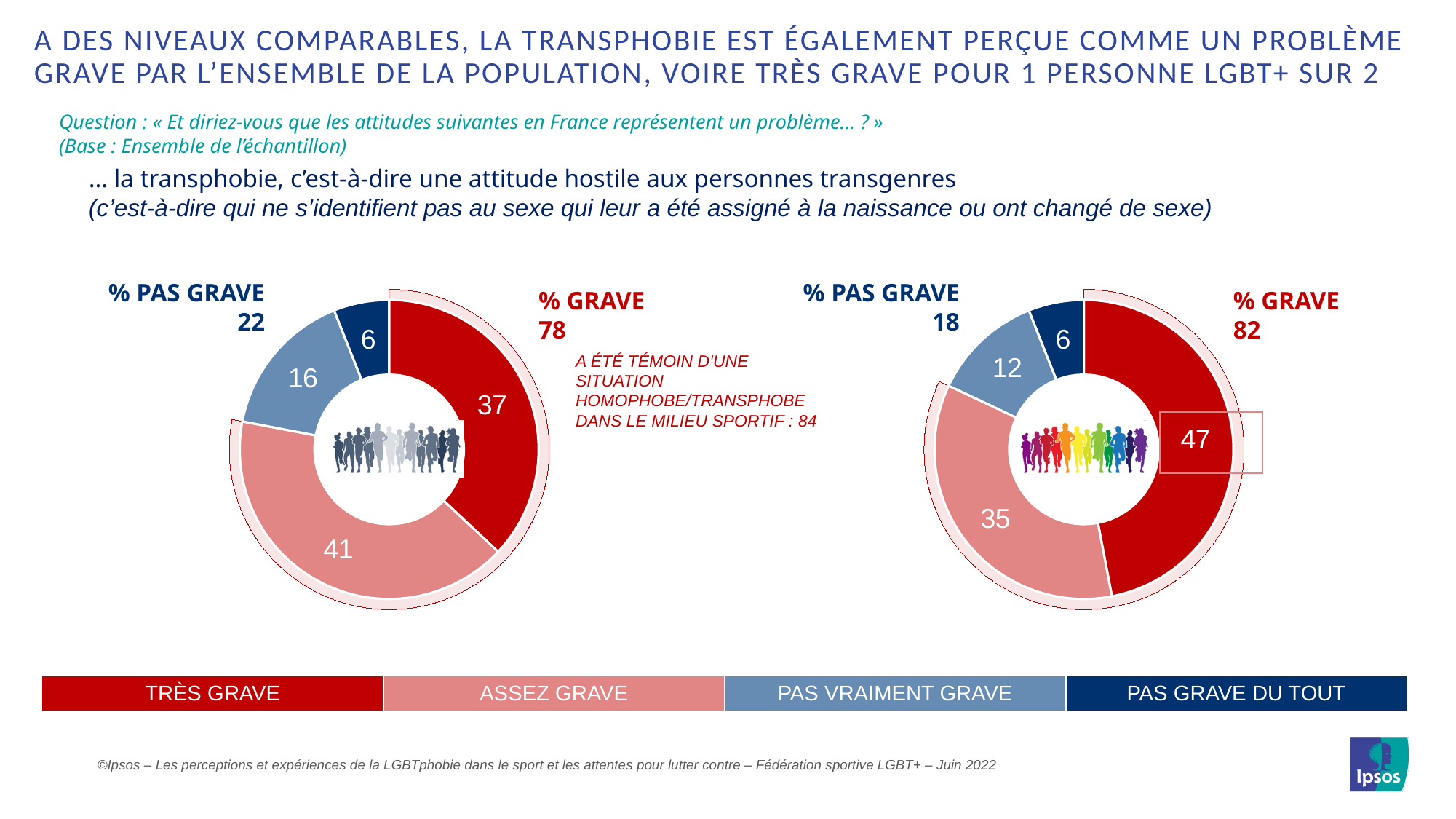
In the left donut chart, what is the value for TRÈS GRAVE? 37 In the right donut chart, what is the value for TRÈS GRAVE? 47 What is the % PAS GRAVE total shown next to the right donut chart? 18 In the right donut chart, which category has the smallest share? PAS GRAVE DU TOUT What type of chart is used on the left of the slide? Donut (pie) chart Which is larger in the right donut chart: TRÈS GRAVE or ASSEZ GRAVE? TRÈS GRAVE In the left donut chart, what is the value for ASSEZ GRAVE? 41 What is the difference between the TRÈS GRAVE values in the right and left donut charts? 10 In the right donut chart, what is the value for PAS VRAIMENT GRAVE? 12 What is the % GRAVE total shown next to the left donut chart? 78 How many categories does the legend at the bottom of the slide list? 4 In the left donut chart, which category has the largest share? ASSEZ GRAVE